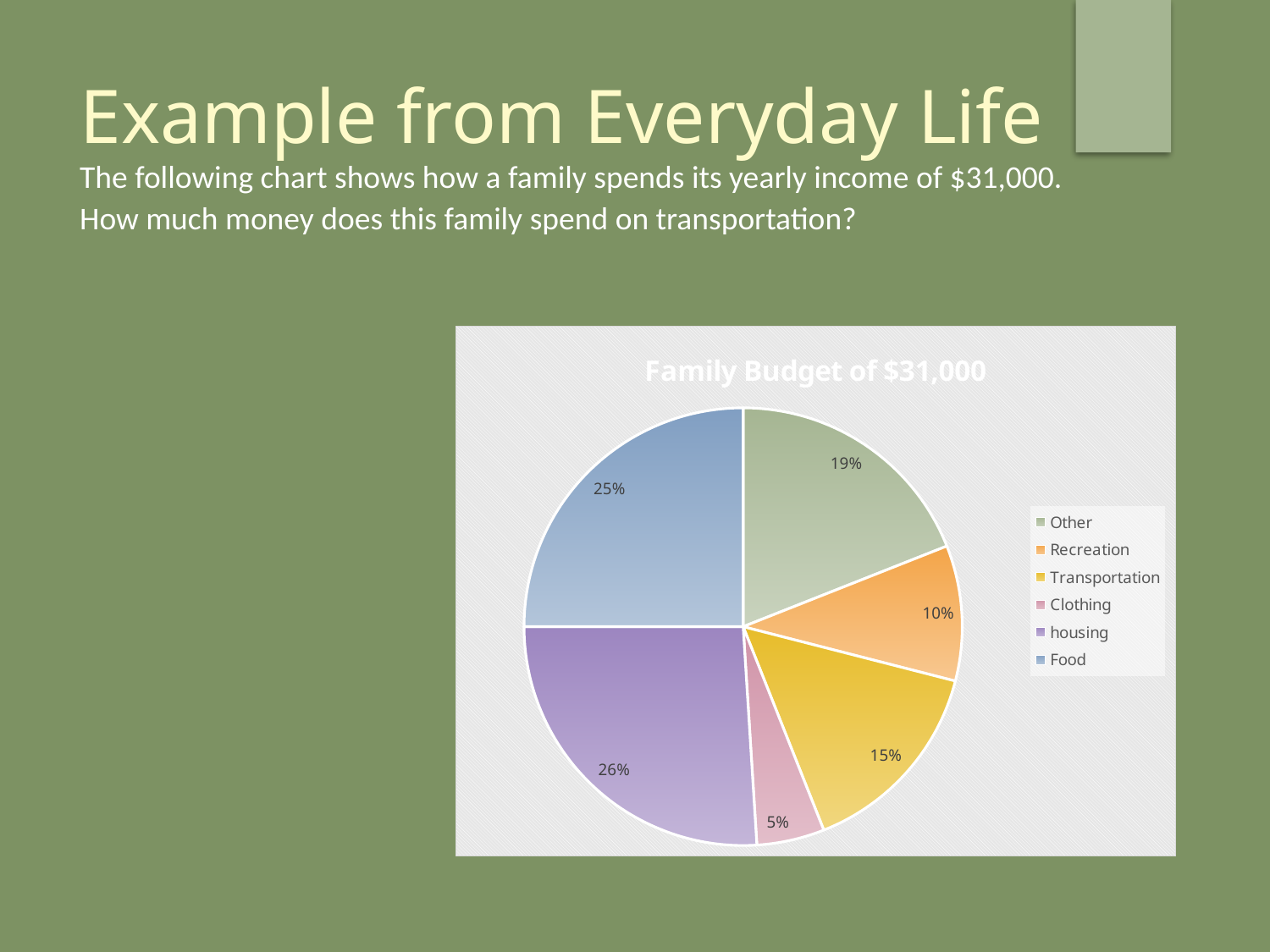
What percentage of the family budget goes to Transportation? 15% What is the title of the chart? Family Budget of $31,000 What is the combined share of Food and housing? 51% What percentage of the family budget goes to Food? 25% What percentage of the family budget goes to Clothing? 5% Which category has the smallest share of the family budget? Clothing What kind of chart is shown on the slide? pie chart Which category has the largest share of the family budget? housing Which is larger, the share for Other or the share for Recreation? Other What is the difference in percentage points between the housing share and the Transportation share? 11 How many categories does the legend list? 6 What percentage of the family budget goes to Recreation? 10%